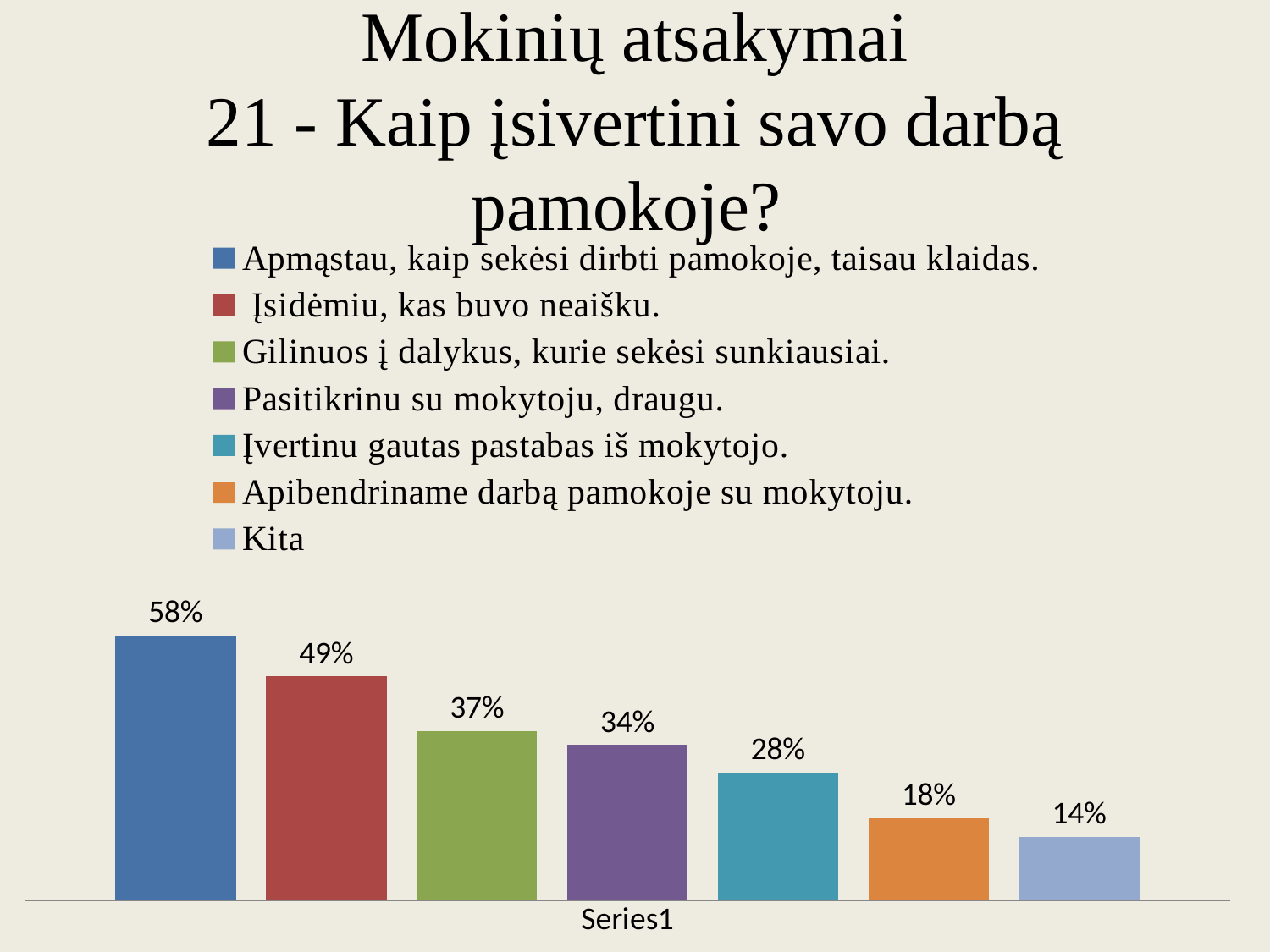
What is the label shown on the horizontal axis below the bars? Series1 Which legend entry has the lowest value? Kita What percentage is shown for "Kita"? 14% What is the difference between the values for "Gilinuos į dalykus, kurie sekėsi sunkiausiai." and "Įvertinu gautas pastabas iš mokytojo."? 9% What percentage is shown for "Įsidėmiu, kas buvo neaišku."? 49% How many entries does the legend list? 7 What kind of chart is shown on the slide? bar chart Which is larger: the value for "Apibendriname darbą pamokoje su mokytoju." or the value for "Įvertinu gautas pastabas iš mokytojo."? Įvertinu gautas pastabas iš mokytojo. What percentage is shown for "Apmąstau, kaip sekėsi dirbti pamokoje, taisau klaidas."? 58% What percentage is shown for "Pasitikrinu su mokytoju, draugu."? 34% How many bars are plotted in the chart? 7 Which legend entry has the highest value? Apmąstau, kaip sekėsi dirbti pamokoje, taisau klaidas.